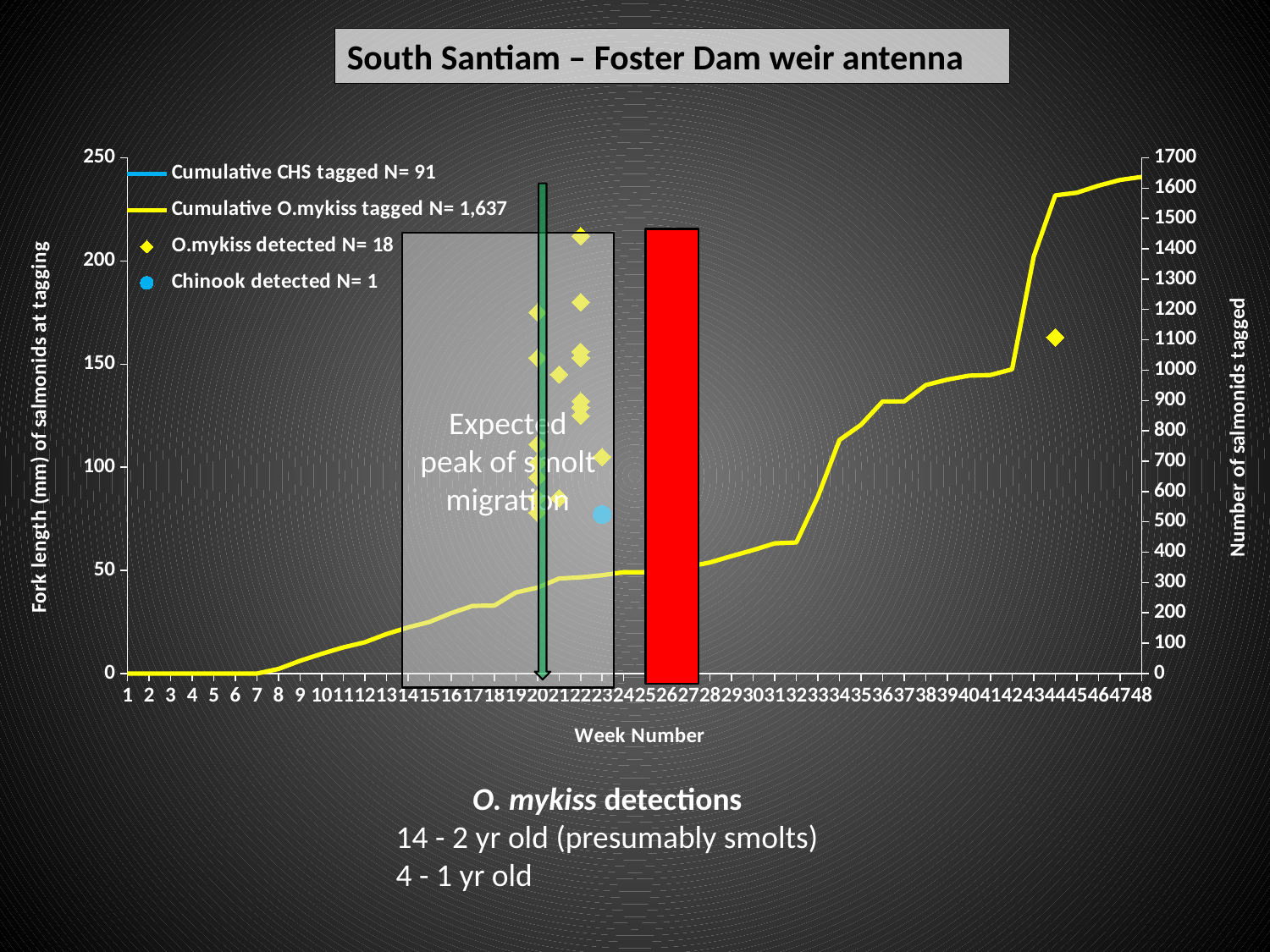
According to the legend, how many O.mykiss were detected (N)? 18 How many more O.mykiss than CHS were cumulatively tagged, based on the legend N values? 1,546 Is the fork length of the single Chinook detected greater or less than 100 mm? less What is the label of the x axis? Week Number Is the Cumulative O.mykiss tagged value at week 48 greater or less than 1500? greater According to the legend, how many Chinook were detected (N)? 1 What is the title of the chart? South Santiam – Foster Dam weir antenna Does the Cumulative O.mykiss tagged line rise or fall as the week number increases? rise How many series does the chart legend list? 4 According to the legend, how many O.mykiss were cumulatively tagged (N)? 1,637 Is the Cumulative O.mykiss tagged value at week 30 greater or less than 500? less According to the legend, how many CHS were cumulatively tagged (N)? 91